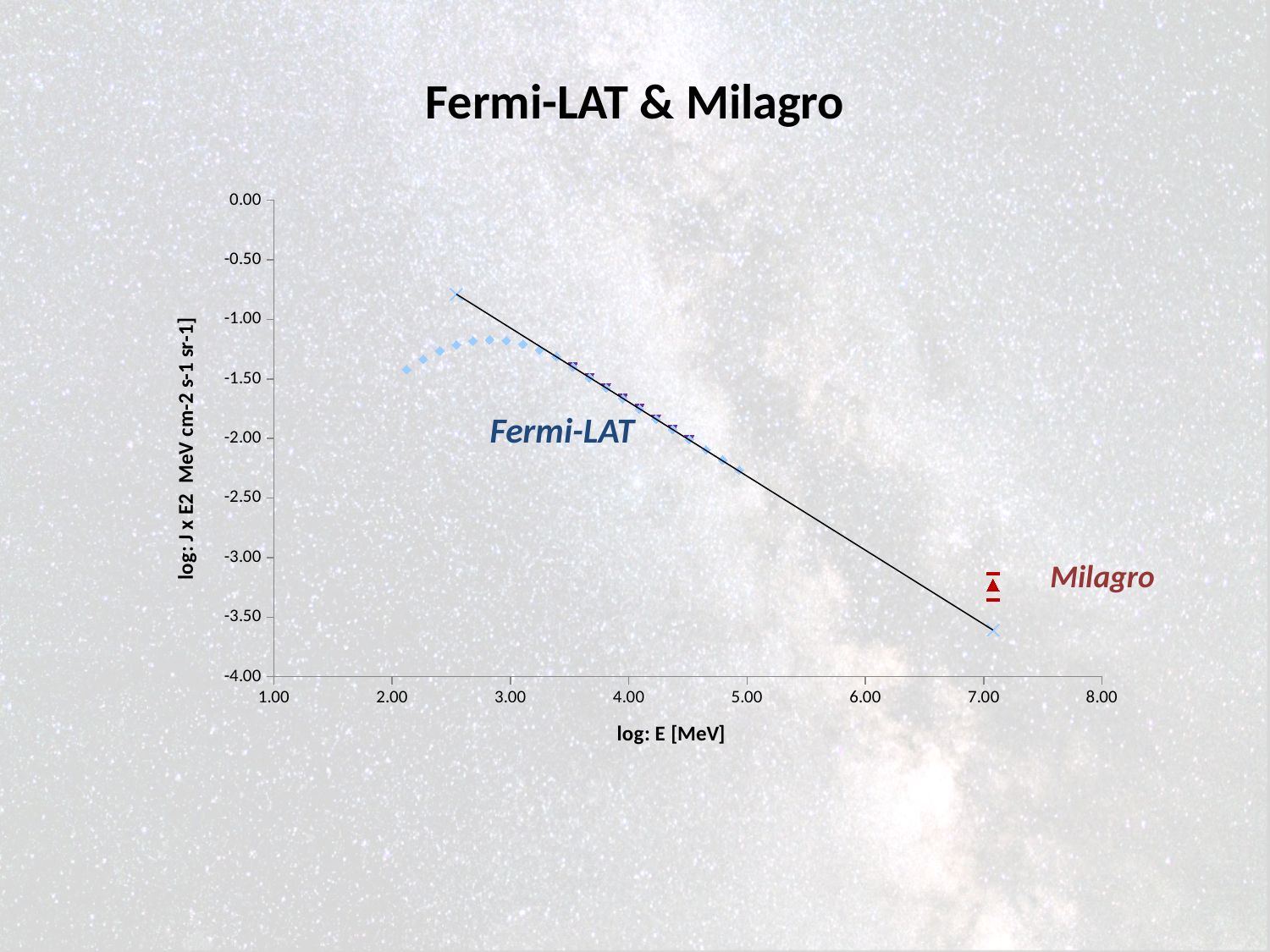
What is the label on the x axis of the chart? log: E [MeV] What is the title of the chart on the slide? Fermi-LAT & Milagro Along the x axis from about 3.00 to 7.00, do the Fermi-LAT values rise or fall? fall Is the value of the Milagro point (near x = 7.00) greater or less than -3.00? less Near x = 7.00, which is higher: the Milagro point or the end of the black fitted line? the Milagro point What kind of chart is shown on the slide? scatter chart Is the highest Fermi-LAT point (near x = 2.80) greater or less than -1.50? greater Is the leftmost Fermi-LAT point (near x = 2.10) greater or less than -1.50? greater